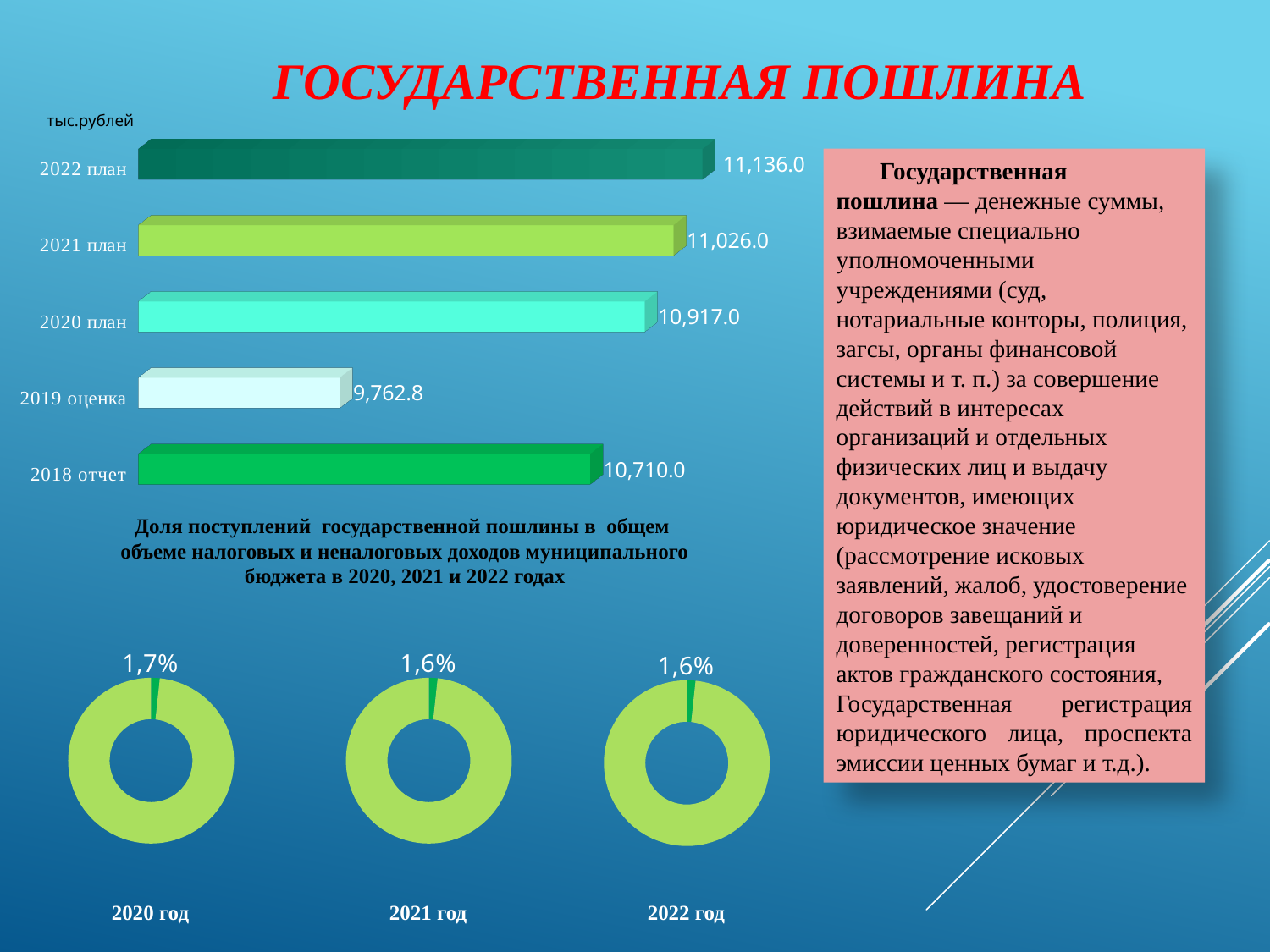
In the bar chart, which category has the lowest value? 2019 оценка How many categories does the bar chart show? 5 In the bar chart, what is the difference between the values for 2020 план and 2018 отчет? 207.0 In the bar chart, what is the value for 2022 план? 11,136.0 In the donut chart for 2022 год, what share is shown for the state duty? 1,6% What type of chart is the chart at the top of the slide showing values in тыс.рублей? bar chart In the donut chart for 2020 год, what share is shown for the state duty? 1,7% In the bar chart, which is larger: the value for 2021 план or the value for 2020 план? 2021 план In the bar chart, which category has the highest value? 2022 план In the bar chart, what is the difference between the values for 2022 план and 2021 план? 110.0 In the bar chart, what is the value for 2018 отчет? 10,710.0 In the bar chart, what is the value for 2019 оценка? 9,762.8